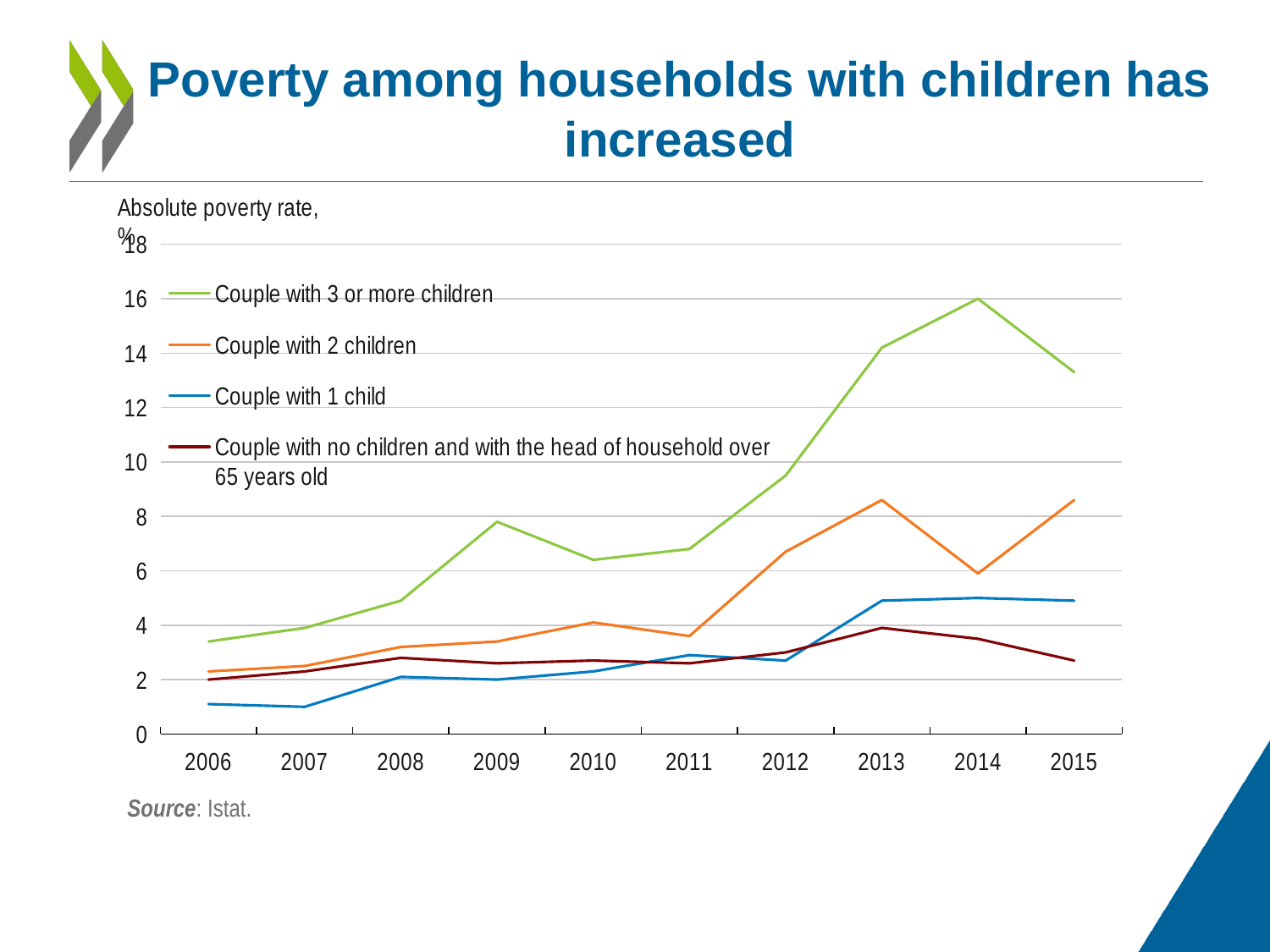
What kind of chart is shown on the slide? Line chart How many series does the legend list? 4 Is the value for 'Couple with 1 child' in 2006 greater or less than 2? less How many years are shown along the x axis? 10 In 2015, which is larger: the value for 'Couple with 1 child' or for 'Couple with no children and with the head of household over 65 years old'? Couple with 1 child Does the absolute poverty rate for 'Couple with 3 or more children' rise or fall between 2006 and 2014? rise What is the source of the data cited below the chart? Istat Which series has the lowest absolute poverty rate in 2006? Couple with 1 child Is the value for 'Couple with 3 or more children' in 2013 greater or less than 12? greater Which series has the highest absolute poverty rate in 2015? Couple with 3 or more children In which year does the 'Couple with 3 or more children' series reach its highest value? 2014 Is the value for 'Couple with no children and with the head of household over 65 years old' in 2015 greater or less than 4? less